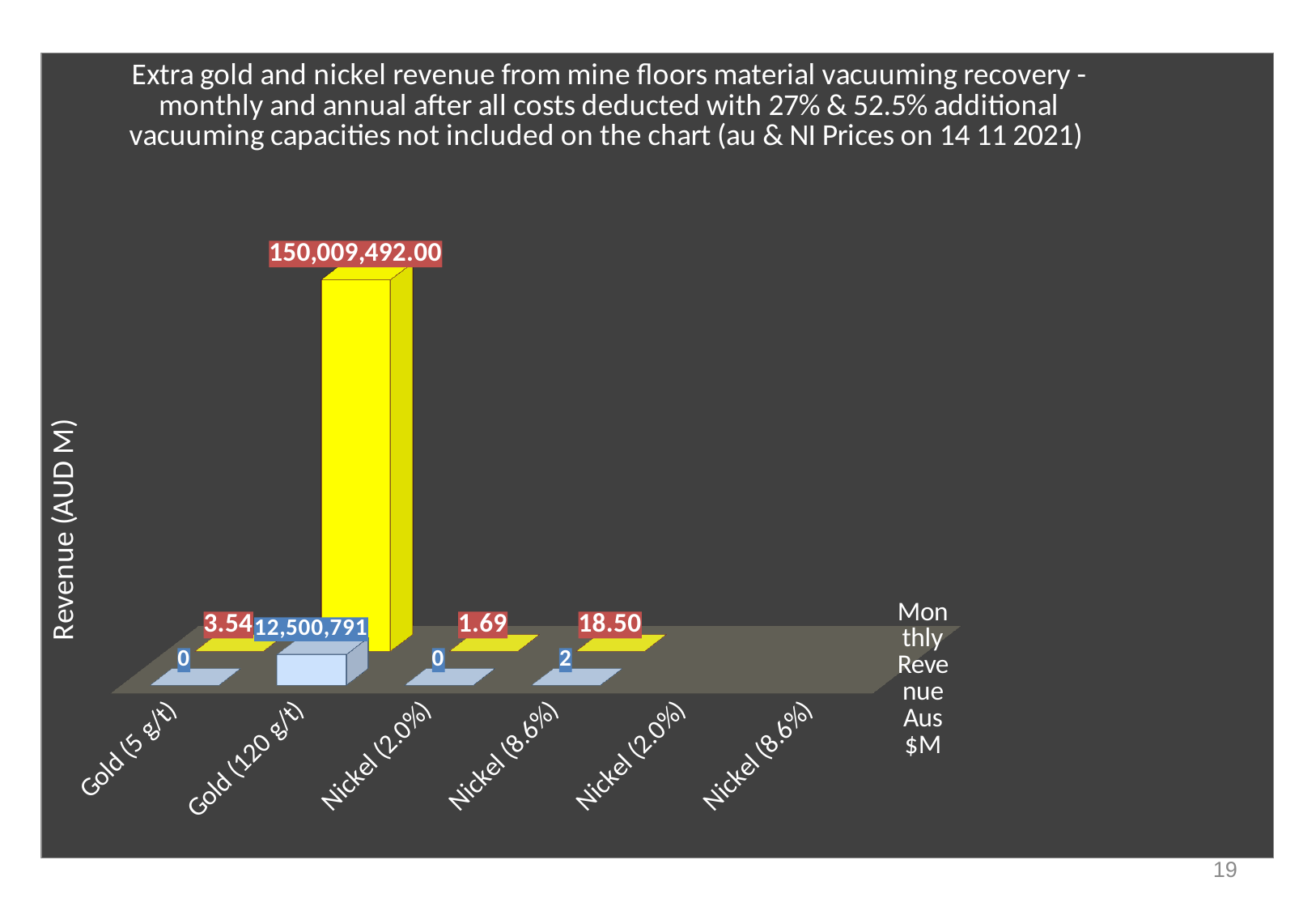
What is the title of the vertical axis? Revenue (AUD M) What is the value of the yellow (back row) bar for Gold (120 g/t)? 150,009,492.00 What is the value of the blue (front row) bar for the first Nickel (8.6%) category? 2 What is the difference between the yellow (back row) values for the first Nickel (8.6%) and Gold (5 g/t)? 14.96 How many category labels are shown along the x axis? 6 What is the value of the blue (front row) bar for Gold (120 g/t)? 12,500,791 Among the yellow (back row) bars, which is larger: Gold (5 g/t) or the first Nickel (8.6%)? Nickel (8.6%) What is the difference between the yellow (back row) values for the first Nickel (8.6%) and the first Nickel (2.0%)? 16.81 What is the value of the yellow (back row) bar for the first Nickel (8.6%) category? 18.50 What is the value of the yellow (back row) bar for Gold (5 g/t)? 3.54 Which category has the tallest yellow (back row) bar? Gold (120 g/t) What kind of chart is shown on the slide? Bar chart